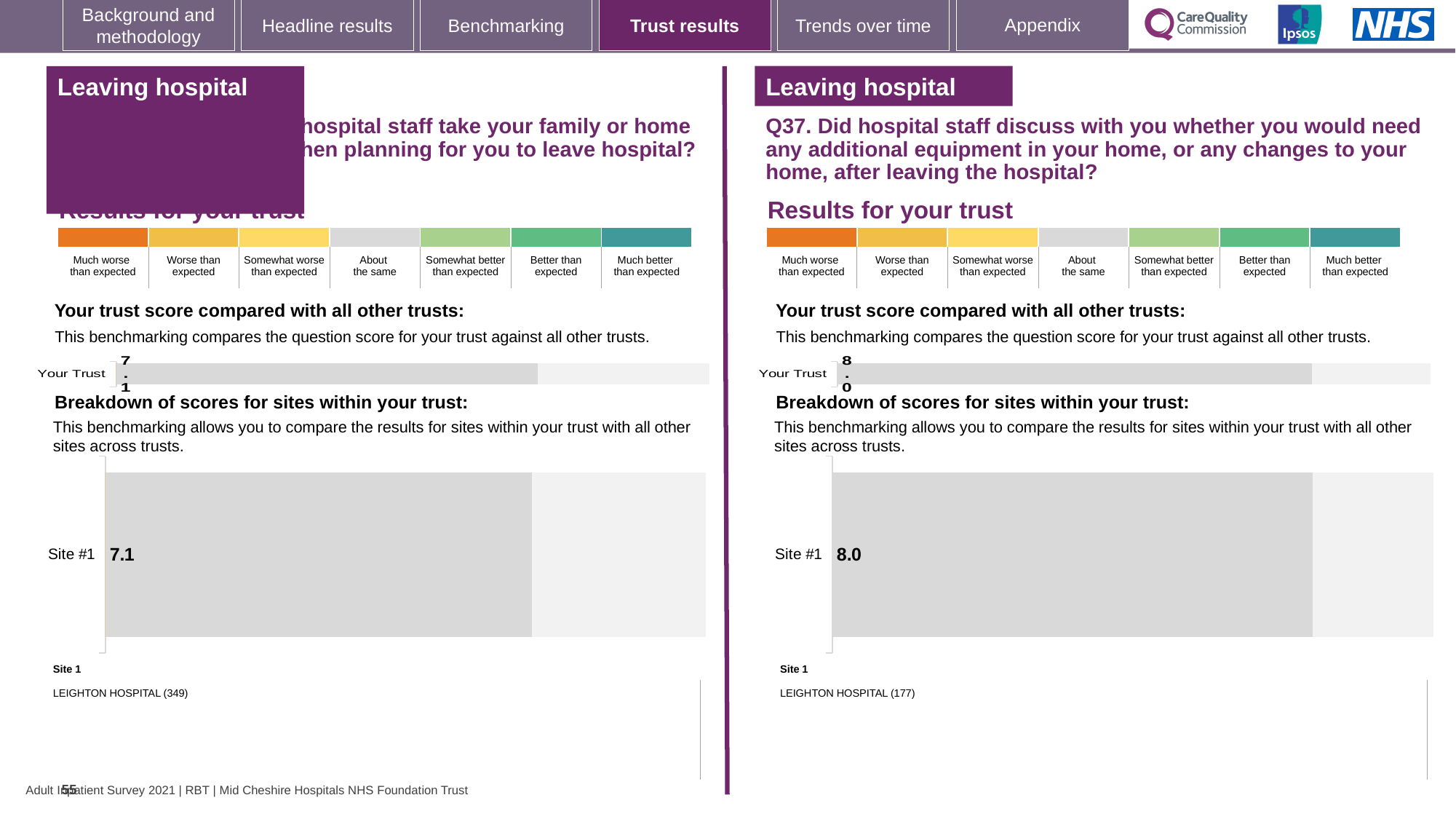
Which site is listed as Site 1 beneath the right-hand (Q37) breakdown chart? LEIGHTON HOSPITAL (177) How many sites are shown in the left-hand 'Breakdown of scores for sites within your trust' chart? 1 On the left half of the slide, in the 'Your trust score compared with all other trusts' chart, what is the value for Your Trust? 7.1 On the left half of the slide, in the 'Breakdown of scores for sites within your trust' chart, what is the value for Site #1? 7.1 What kind of chart is the 'Breakdown of scores for sites within your trust' chart on the right half of the slide? Bar chart What is the difference between the Site #1 score in the right-hand (Q37) breakdown chart and the Site #1 score in the left-hand breakdown chart? 0.9 How many sites are shown in the right-hand (Q37) 'Breakdown of scores for sites within your trust' chart? 1 On the right half of the slide (Q37), in the 'Breakdown of scores for sites within your trust' chart, what is the value for Site #1? 8.0 On the right half of the slide (Q37), in the 'Your trust score compared with all other trusts' chart, what is the value for Your Trust? 8.0 Which site is listed as Site 1 beneath the left-hand breakdown chart? LEIGHTON HOSPITAL (349) What kind of chart is the 'Your trust score compared with all other trusts' chart on the left half of the slide? Bar chart Which is larger: the Site #1 score in the left-hand breakdown chart or the Site #1 score in the right-hand (Q37) breakdown chart? Right-hand (Q37) Site #1, 8.0